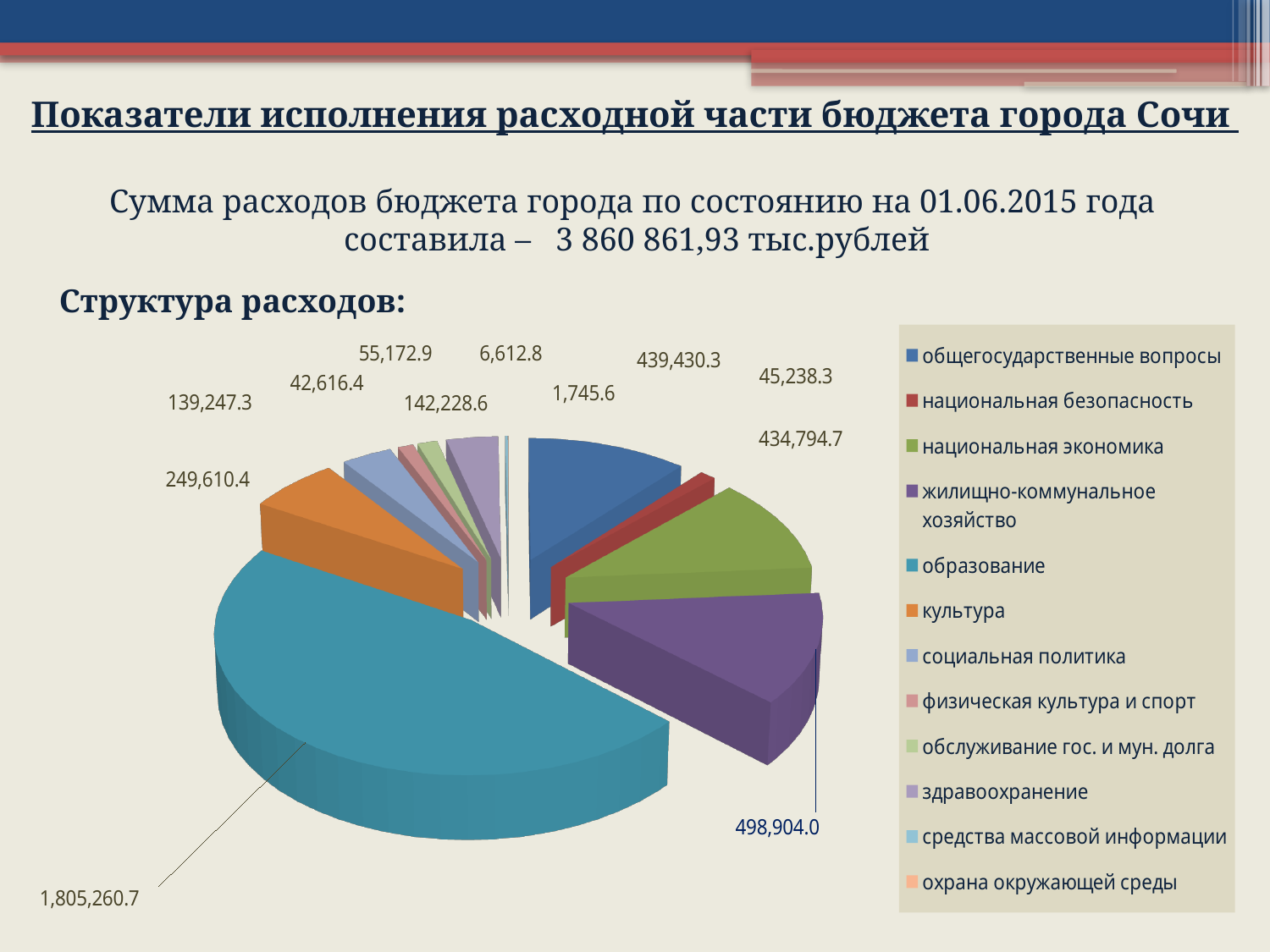
What is the value for образование in the pie chart? 1,805,260.7 How many categories does the legend of the pie chart list? 12 What is the value for жилищно-коммунальное хозяйство in the pie chart? 498,904.0 What kind of chart is shown on the slide? pie chart Which category has the largest slice in the pie chart? образование What is the value for национальная безопасность in the pie chart? 45,238.3 What is the value for здравоохранение in the pie chart? 142,228.6 What is the heading printed directly above the pie chart? Структура расходов: Which is larger: общегосударственные вопросы or национальная экономика? общегосударственные вопросы What is the value for культура in the pie chart? 249,610.4 What is the smallest value labelled on the pie chart? 1,745.6 What is the difference between the values for жилищно-коммунальное хозяйство and национальная экономика? 64,109.3